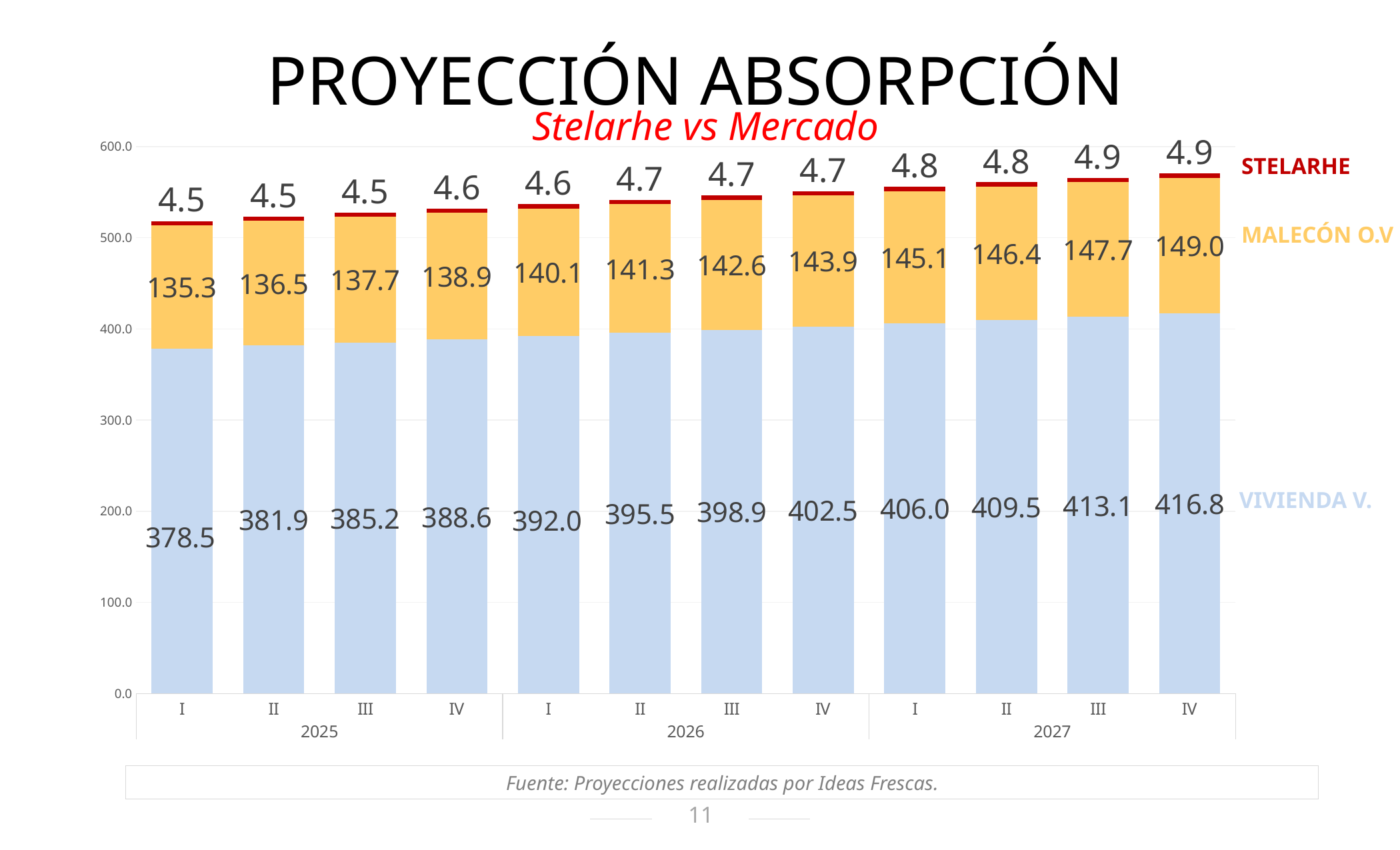
In which quarter is the MALECÓN O.V value lowest? I 2025 What is the VIVIENDA V. value for quarter I of 2025? 378.5 What is the STELARHE value for quarter IV of 2027? 4.9 Is the total of the stacked bar for quarter I of 2025 greater or less than 500? greater How many series does the chart show? 3 Which is larger in quarter II of 2026: the VIVIENDA V. value or the MALECÓN O.V value? VIVIENDA V. In which quarter is the VIVIENDA V. value highest? IV 2027 What is the MALECÓN O.V value for quarter III of 2026? 142.6 What is the total of the stacked bar for quarter IV of 2027? 570.7 What kind of chart is shown on the slide? Stacked bar chart How many quarters (bars) are shown on the chart? 12 What is the difference between the VIVIENDA V. value in quarter IV of 2027 and quarter I of 2025? 38.3